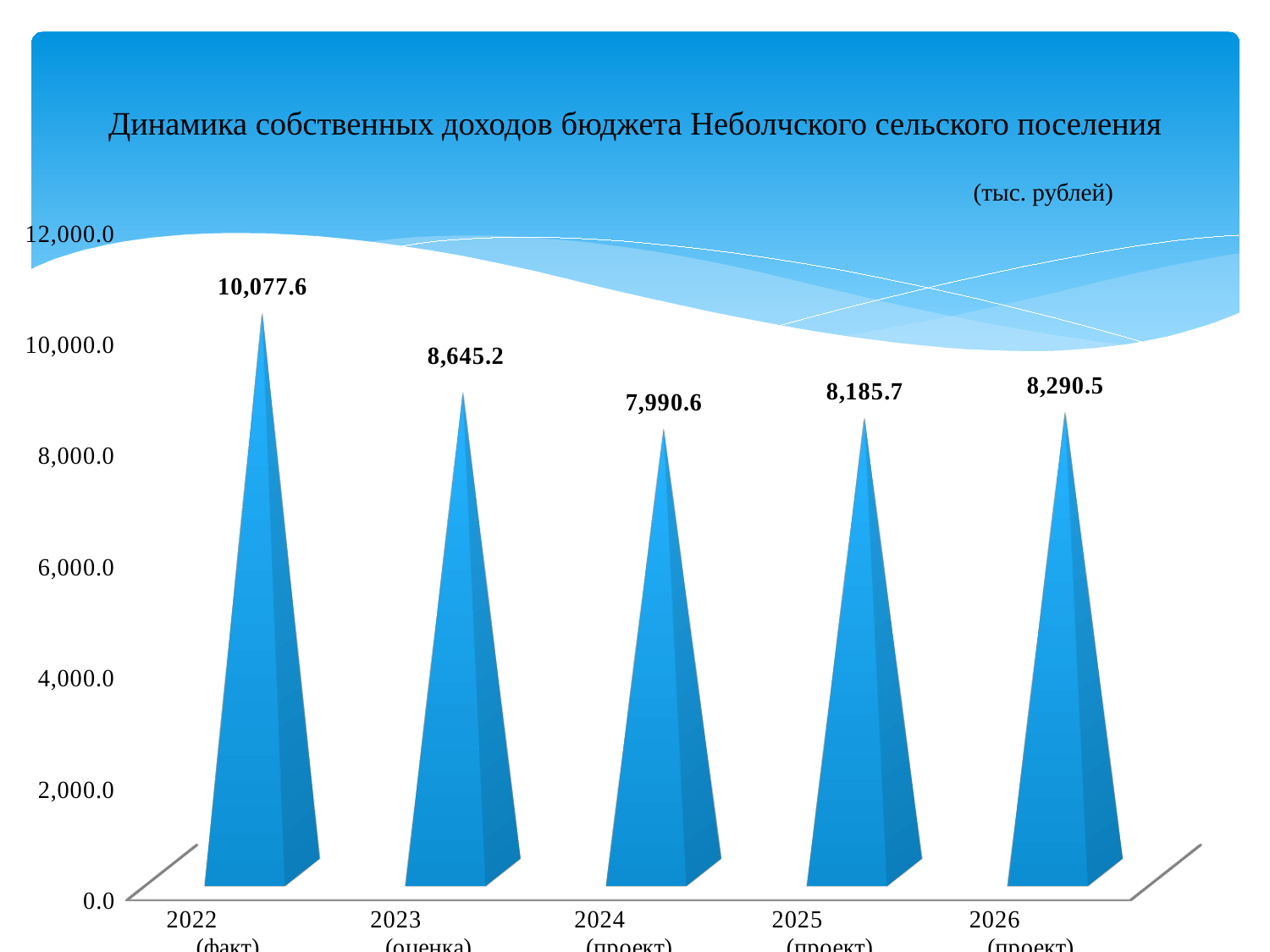
What is the value for 2024 (проект)? 7,990.6 How many years are shown on the x axis? 5 Is the value for 2024 greater or less than 8,000.0? less What is the difference between the values for 2022 and 2023? 1,432.4 What is the difference between the values for 2026 and 2025? 104.8 Which year has the lowest value? 2024 (проект) Which year has the highest value? 2022 (факт) What is the value for 2026 (проект)? 8,290.5 What is the value for 2022 (факт)? 10,077.6 What unit is stated for the values in the chart? тыс. рублей What kind of chart is shown on the slide? bar chart Which is larger, the value for 2023 or the value for 2025? 2023